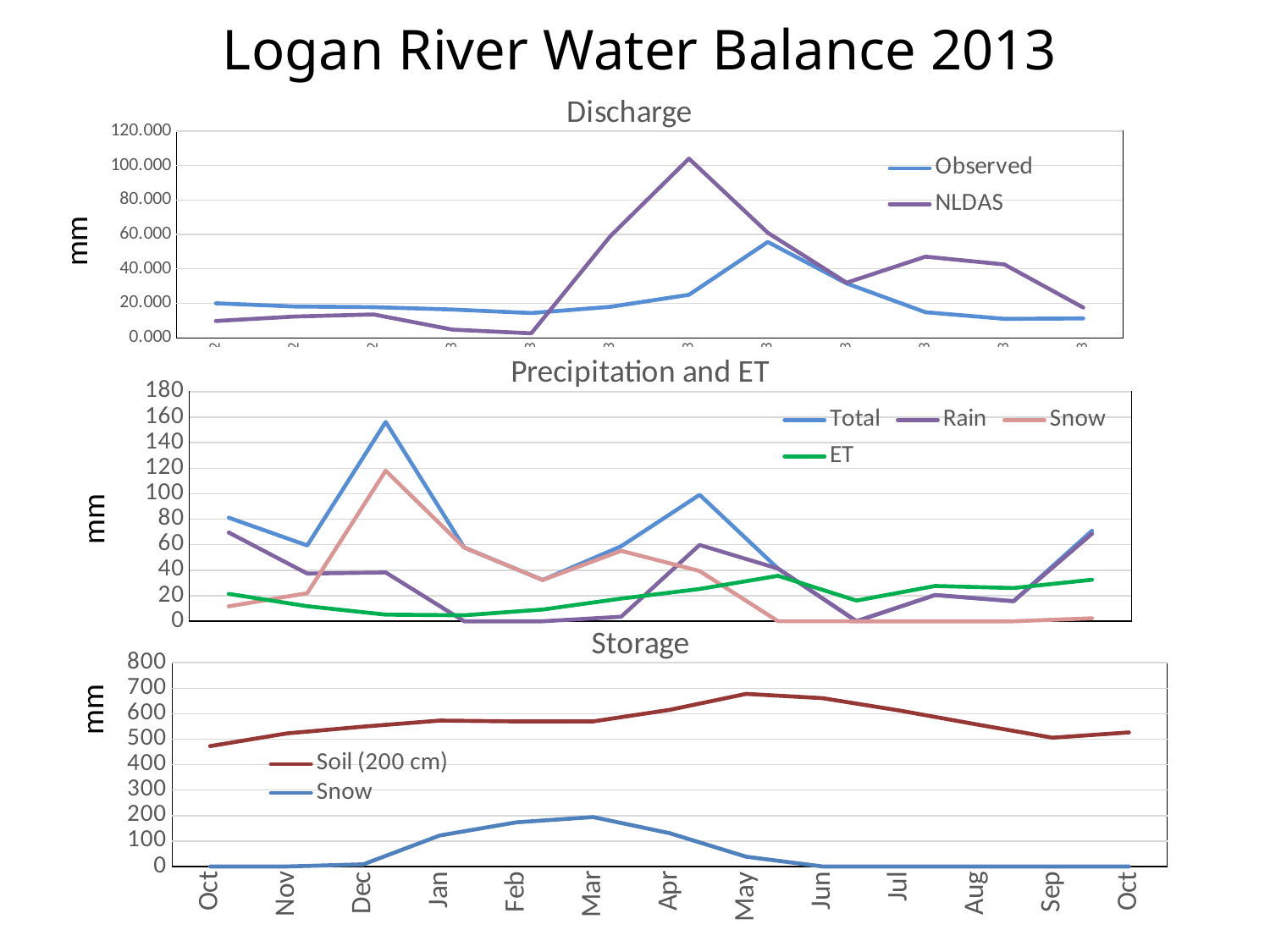
In the Discharge chart, which series reaches the higher peak, Observed or NLDAS? NLDAS In the Precipitation and ET chart, which series is drawn in green? ET How many series does the legend of the Precipitation and ET chart list? 4 In the Storage chart, which month has the highest Snow value? Mar How many series does the legend of the Discharge chart list? 2 In the Storage chart, is the Snow value for Mar greater or less than 100? greater How many series does the legend of the Storage chart list? 2 In the Storage chart, which month has the highest Soil (200 cm) value? May In the Storage chart, is the Soil (200 cm) value for May greater or less than 600? greater In the Storage chart, which month has the lowest Soil (200 cm) value? Oct In the Discharge chart, is the peak value of the NLDAS series greater or less than 80.000? greater What kind of chart is the Discharge chart? line chart